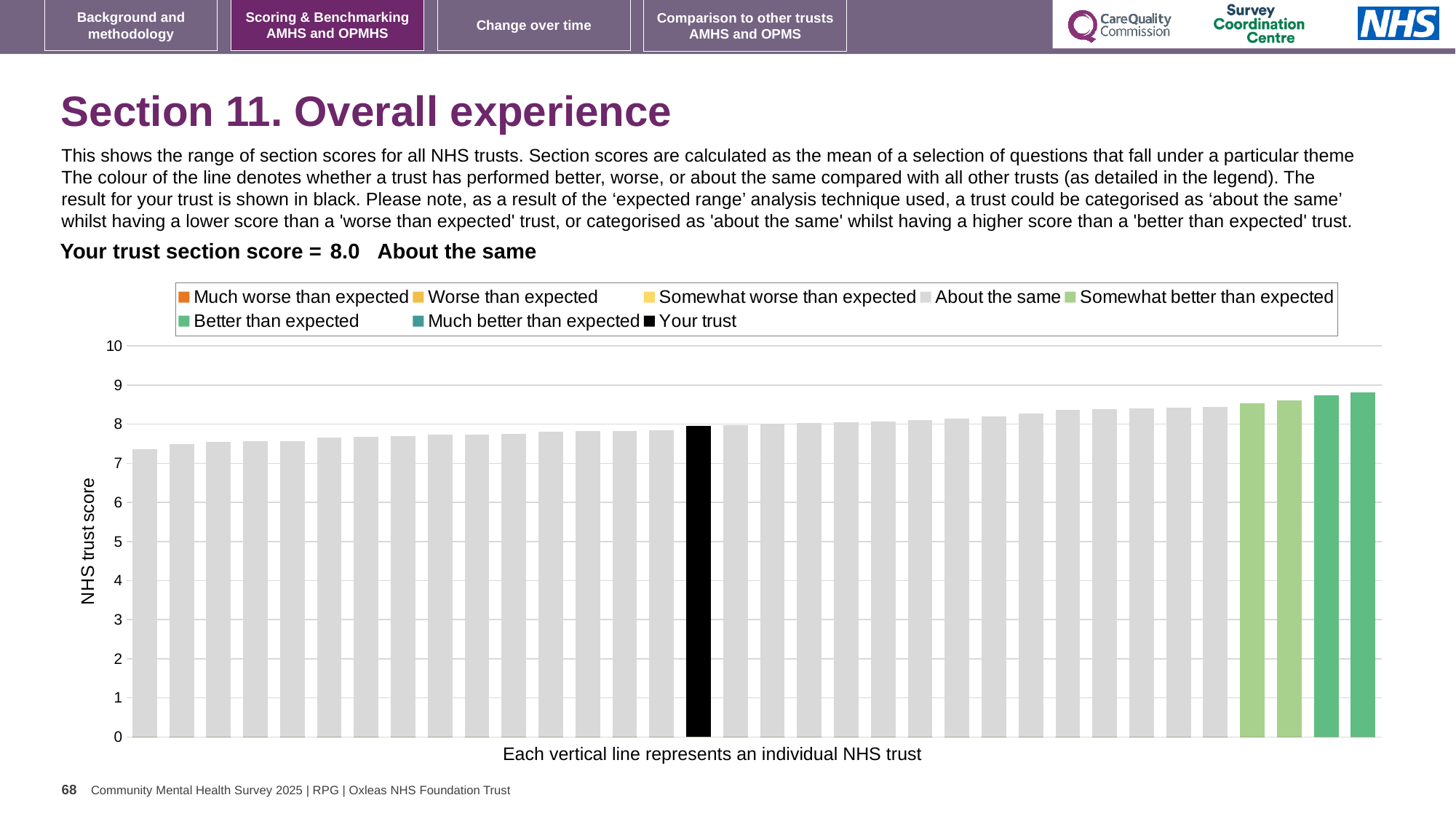
What is the section score for your trust shown on the slide? 8.0 What kind of chart is shown on the slide? bar chart Which category is your trust placed in for this section? About the same Is the value of the leftmost (lowest) bar greater or less than 7? greater Is the value for your trust greater or less than 7? greater How many entries does the chart legend list? 8 What colour is the bar representing your trust? black How many bars (NHS trusts) are plotted in the chart? 34 Which bar has the highest value? the rightmost bar Is the value of the rightmost (highest) bar greater or less than 9? less How many bars are coloured green (somewhat better or better than expected)? 4 Do the bar values rise or fall from left to right along the x axis? rise